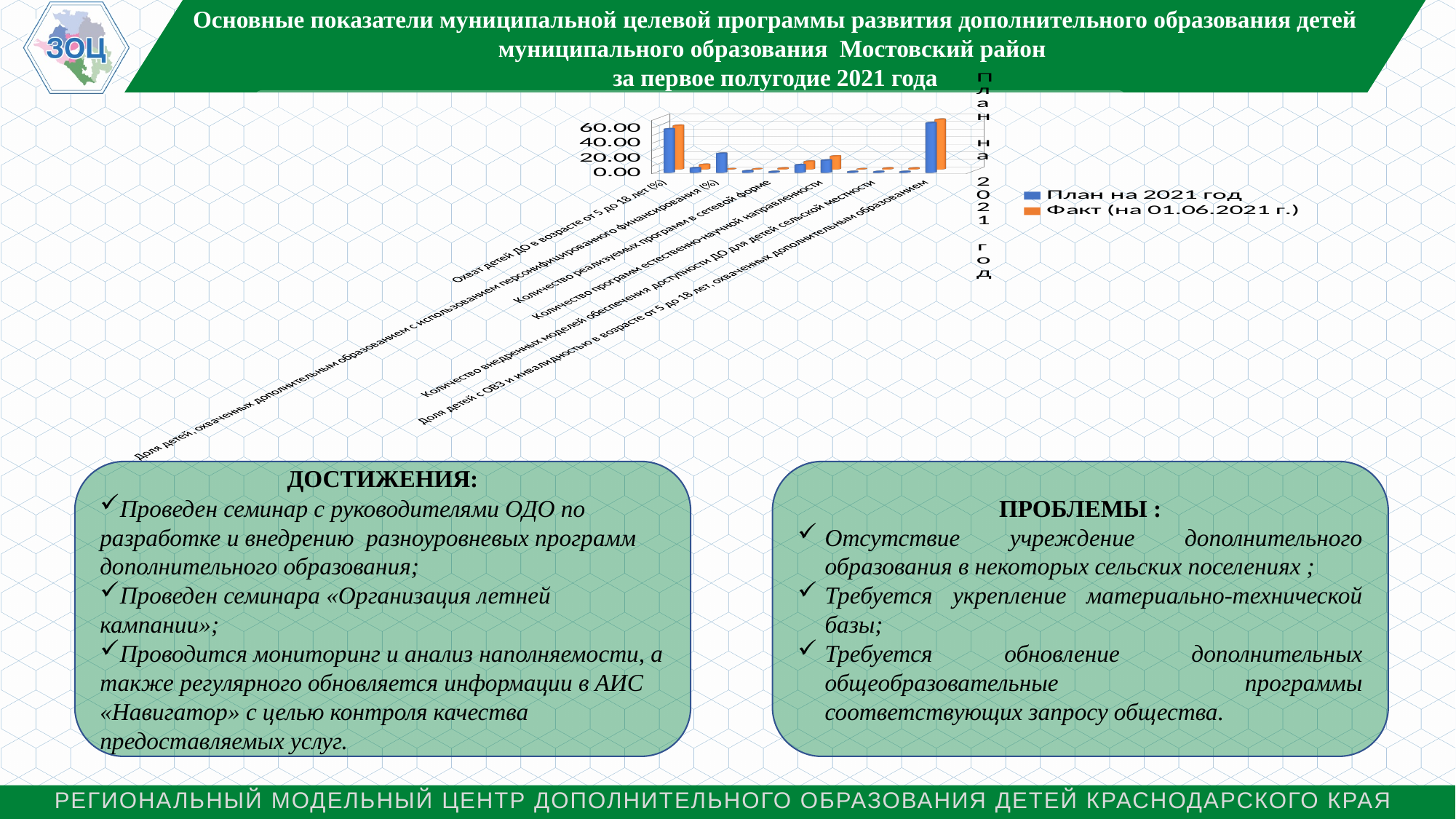
How many series does the chart legend list? 2 Which colour represents the series "Факт (на 01.06.2021 г.)" in the chart? orange Is the "План на 2021 год" value for "Количество реализуемых программ в сетевой форме" greater or less than 40? less What kind of chart is shown on the slide? bar chart Is the "План на 2021 год" value for "Доля детей с ОВЗ и инвалидностью в возрасте от 5 до 18 лет, охваченных дополнительным образованием" greater or less than 40? greater Which category has the highest "План на 2021 год" value in the chart? Доля детей с ОВЗ и инвалидностью в возрасте от 5 до 18 лет, охваченных дополнительным образованием What are the two series named in the chart legend? План на 2021 год; Факт (на 01.06.2021 г.) What is the highest tick value shown on the chart's value axis? 60.00 Is the "План на 2021 год" value for "Охват детей ДО в возрасте от 5 до 18 лет (%)" greater or less than 20? greater Which is larger: the "План на 2021 год" value for "Охват детей ДО в возрасте от 5 до 18 лет (%)" or for "Количество реализуемых программ в сетевой форме"? Охват детей ДО в возрасте от 5 до 18 лет (%)